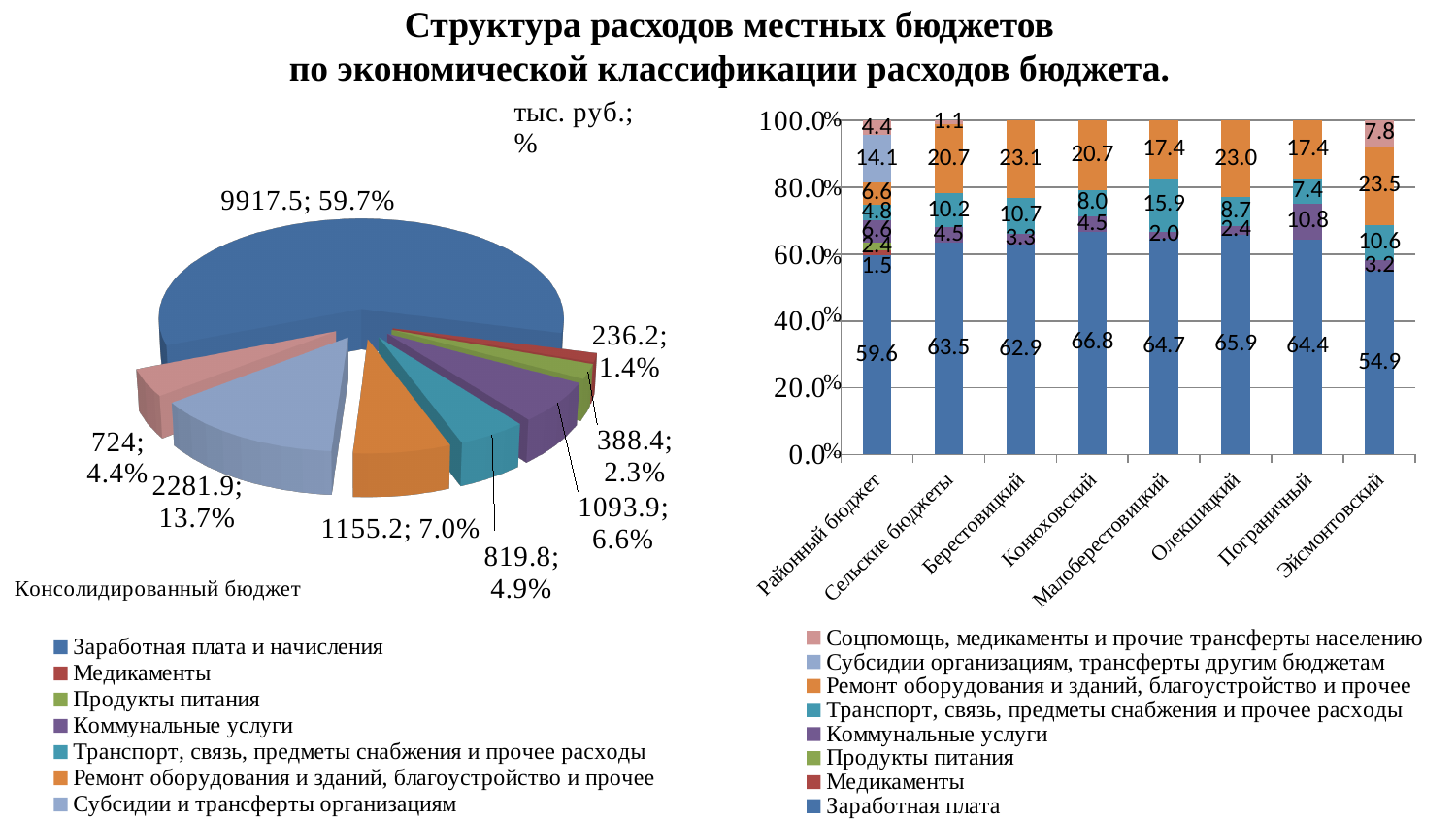
In the stacked bar chart on the right, what is the value of Заработная плата for Эйсмонтовский? 54.9 In the stacked bar chart on the right, which has the larger value for Ремонт оборудования и зданий, благоустройство и прочее: Берестовицкий or Пограничный? Берестовицкий In the pie chart on the left, what share of the total is Субсидии и трансферты организациям? 13.7% How many budget categories are shown on the x axis of the stacked bar chart on the right? 8 In the pie chart on the left, which legend category has the smallest slice? Медикаменты What kind of chart is the chart on the right of the slide? Stacked bar chart In the stacked bar chart on the right, which category has the highest value for Заработная плата? Конюховский In the pie chart on the left, what value and share are shown for Заработная плата и начисления? 9917.5; 59.7% How many series does the legend of the stacked bar chart on the right list? 8 How many entries does the legend of the pie chart on the left list? 7 What kind of chart is the chart on the left of the slide? Pie chart In the stacked bar chart on the right, what is the difference between the Заработная плата values for Конюховский and Эйсмонтовский? 11.9